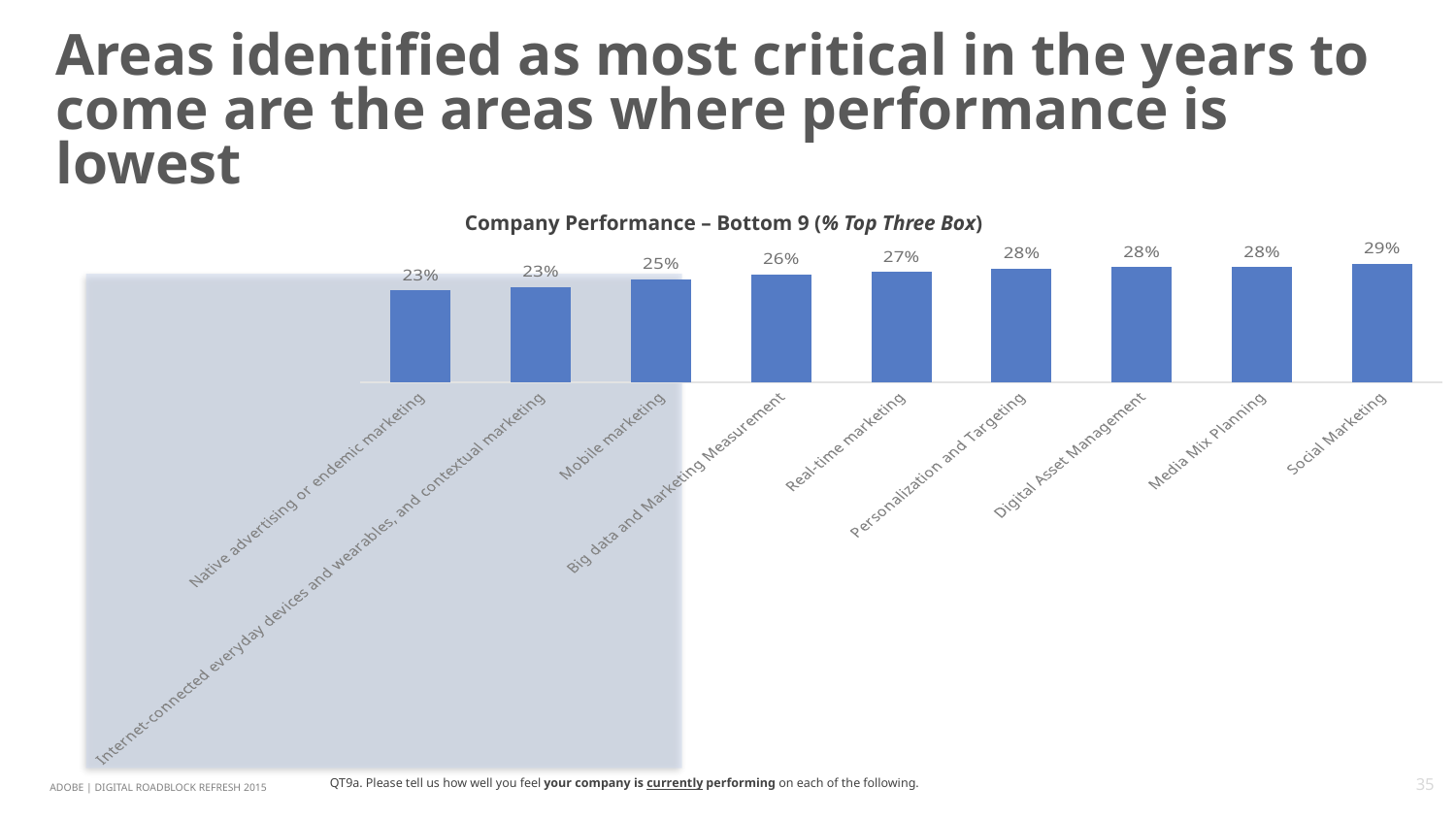
Do the values rise or fall from left to right? Rise What is the value for Native advertising or endemic marketing? 23% What is the value for Real-time marketing? 27% How many categories are shown in the chart? 9 Which is larger, Real-time marketing or Big data and Marketing Measurement? Real-time marketing What is the title of the chart? Company Performance – Bottom 9 (% Top Three Box) What is the value for Big data and Marketing Measurement? 26% What kind of chart is shown? Bar chart What is the value for Social Marketing? 29% Which category has the highest value? Social Marketing What is the value for Mobile marketing? 25% What is the difference between Social Marketing and Mobile marketing? 4 percentage points